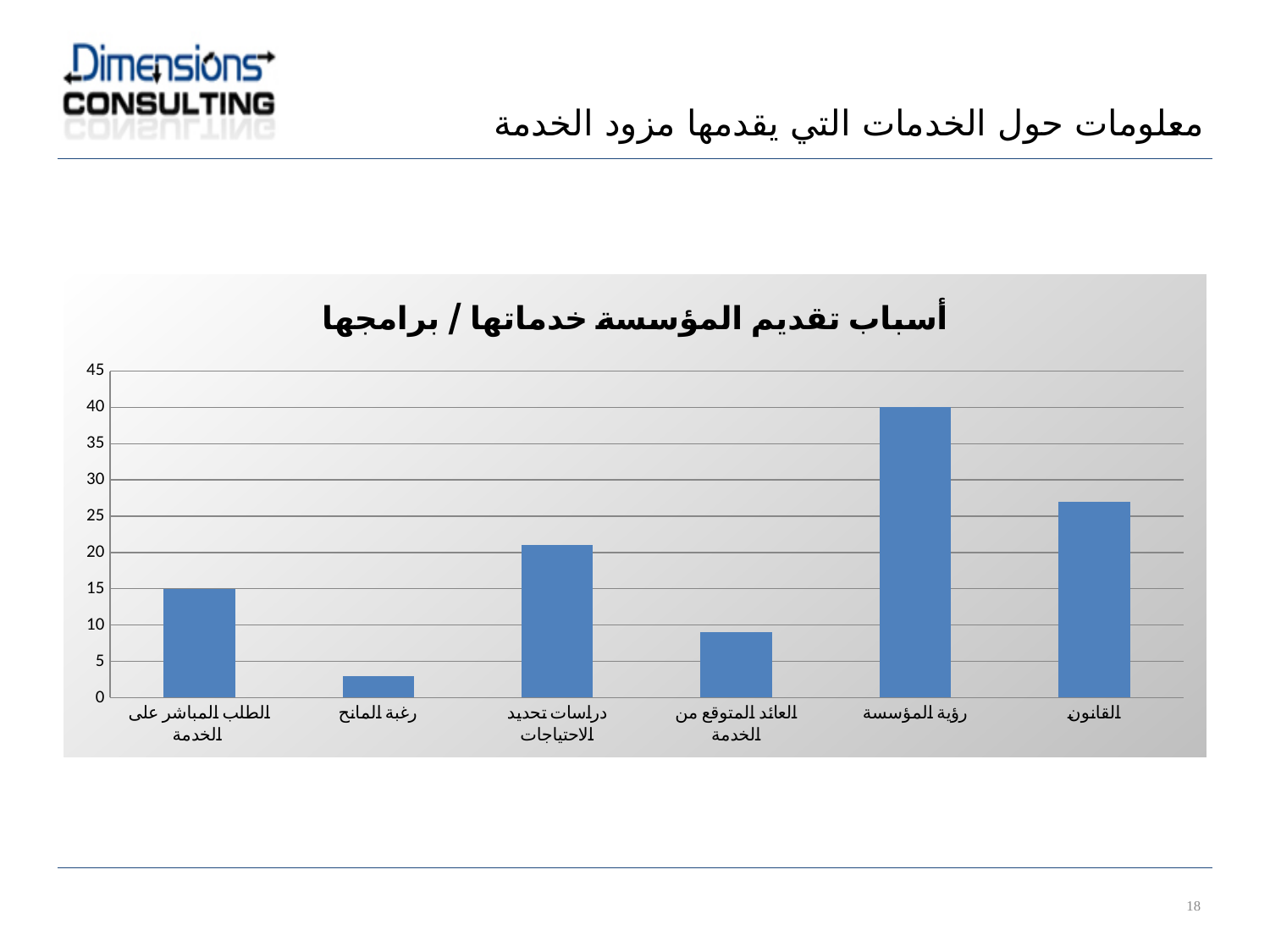
What is the difference between the values for رؤية المؤسسة and الطلب المباشر على الخدمة? 25 Is the value for رغبة المانح greater or less than 5? less Which category has the highest value? رؤية المؤسسة What is the value for رؤية المؤسسة? 40 What is the title of the chart? أسباب تقديم المؤسسة خدماتها / برامجها How many categories are shown in the chart? 6 Which category has the lowest value? رغبة المانح Is the value for القانون greater or less than 25? greater What kind of chart is shown on the slide? Bar chart What is the value for الطلب المباشر على الخدمة? 15 Which is larger, the value for القانون or the value for دراسات تحديد الاحتياجات? القانون